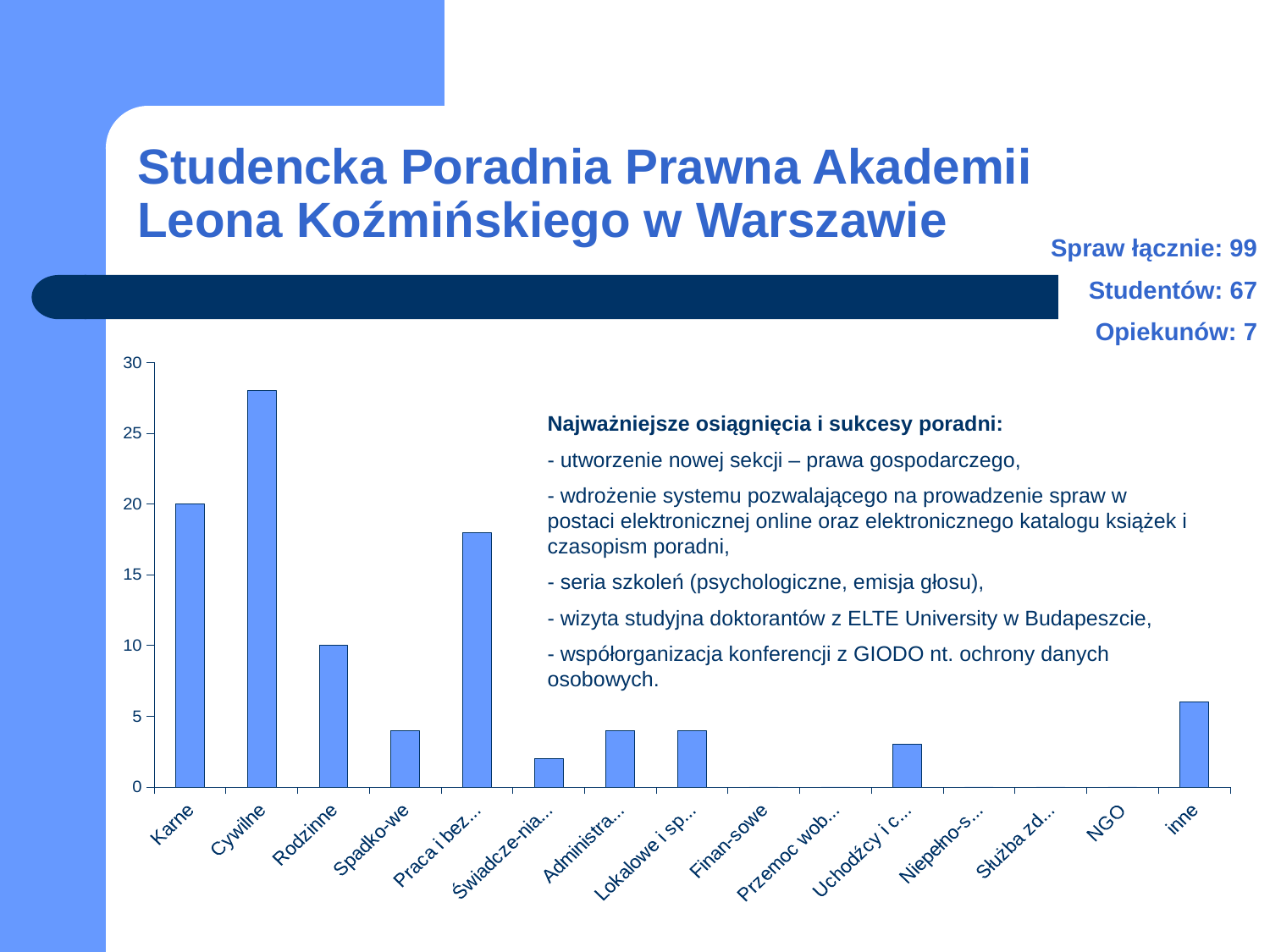
Which is larger, the value for Rodzinne or the value for Uchodźcy i c...? Rodzinne What is the difference between the values for Karne and Rodzinne? 10 Which is larger, the value for Karne or the value for Praca i bez...? Karne Is the value for inne greater or less than 5? greater Is the value for Cywilne greater or less than 25? greater Is the value for Praca i bez... greater or less than 20? less What is the value for Rodzinne? 10 Which category has the highest bar in the chart? Cywilne What kind of chart is shown on the slide? bar chart What is the value for Karne? 20 How many categories are shown on the x axis of the chart? 15